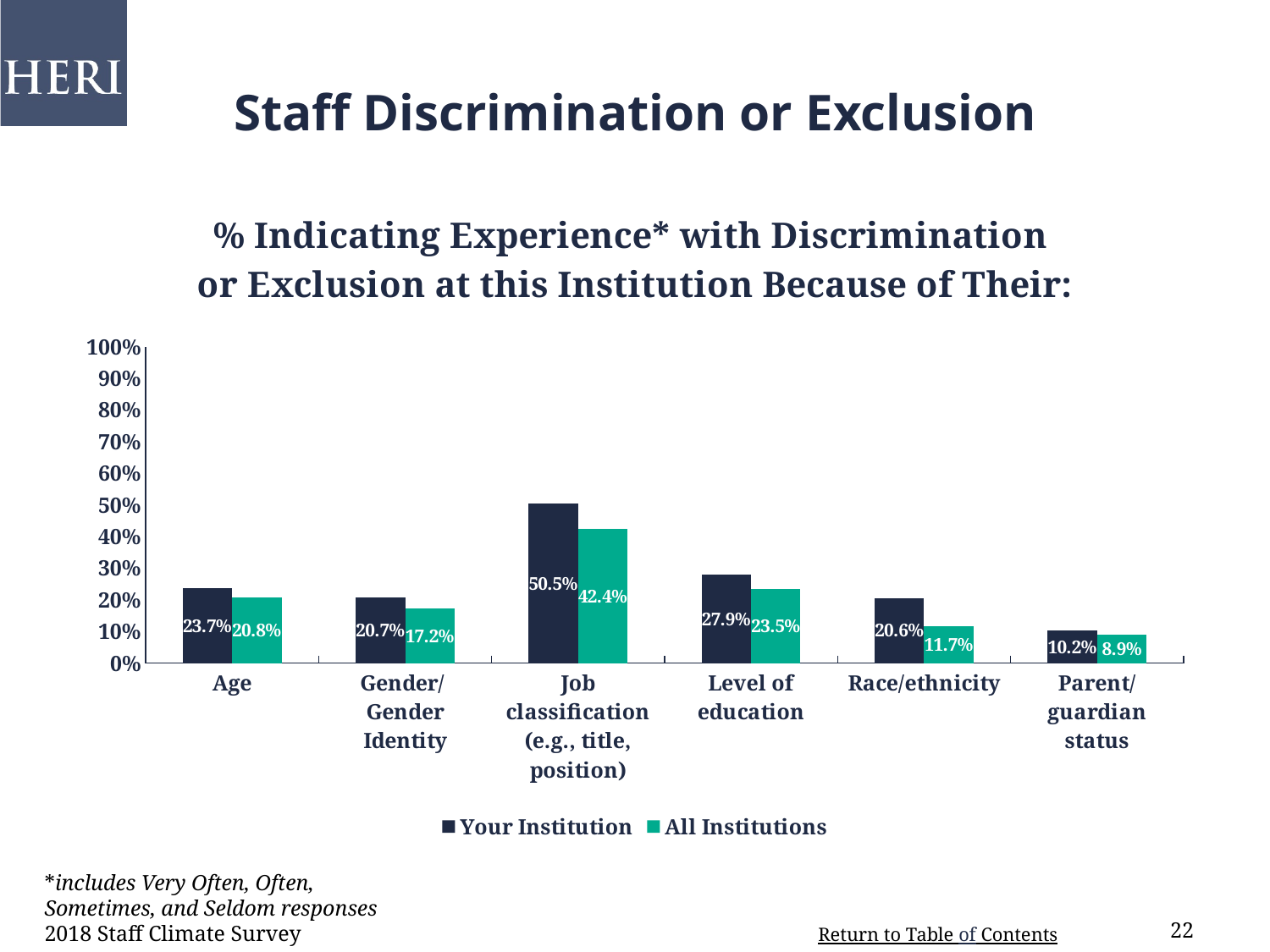
Which category has the highest value for All Institutions? Job classification (e.g., title, position) Which category has the lowest value for Your Institution? Parent/guardian status What is the difference between the Your Institution and All Institutions values for Job classification (e.g., title, position)? 8.1% Is the Your Institution value for Job classification (e.g., title, position) greater or less than 40%? greater What is the Your Institution value for Job classification (e.g., title, position)? 50.5% What is the difference between the Your Institution and All Institutions values for Race/ethnicity? 8.9% What percentage of staff at Your Institution indicated experience with discrimination or exclusion because of their Age? 23.7% What kind of chart is shown on the slide? Bar chart How many categories are shown on the x axis? 6 How many series does the legend list? 2 For Level of education, which is larger: the Your Institution value or the All Institutions value? Your Institution What is the All Institutions value for Race/ethnicity? 11.7%